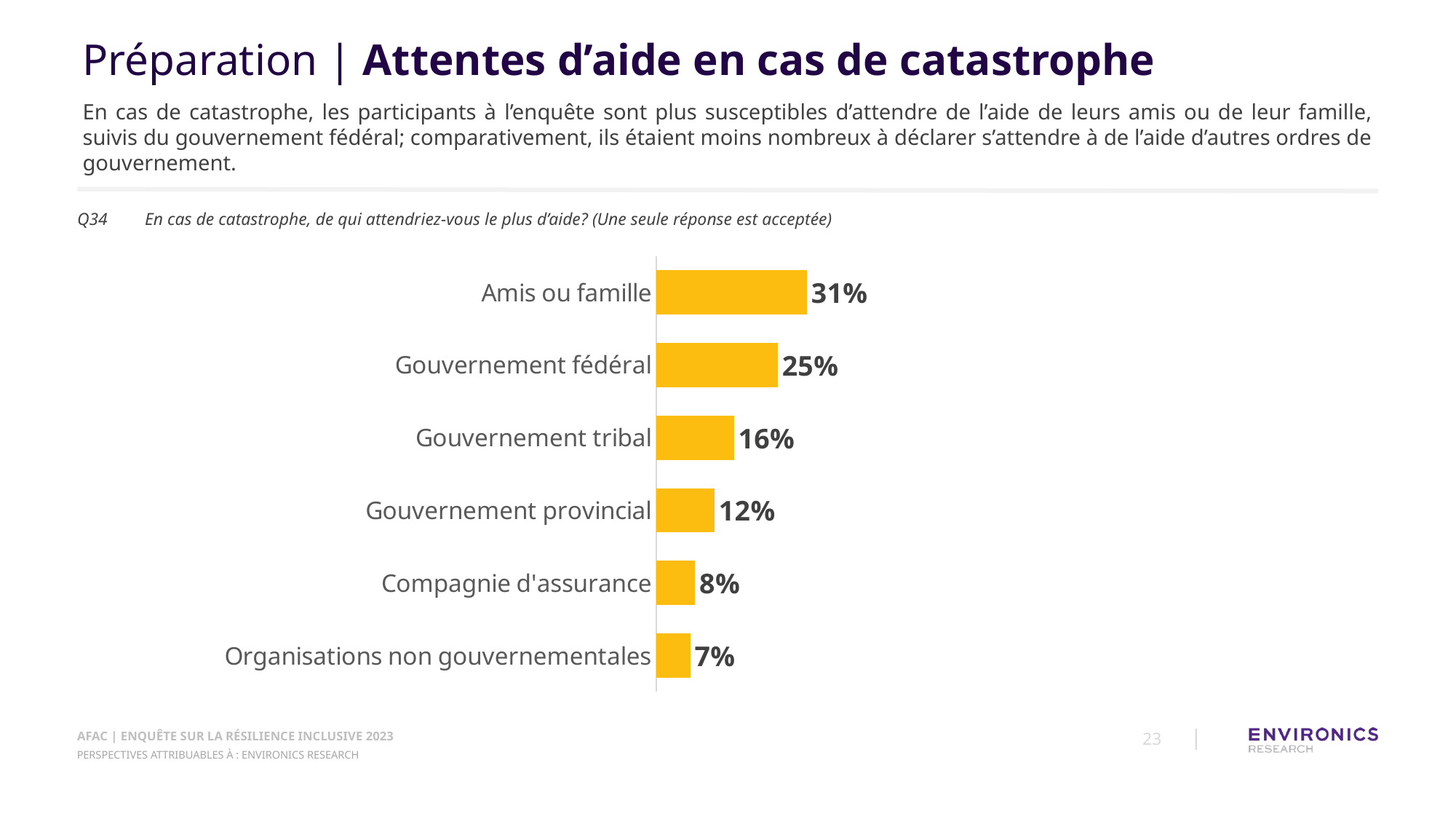
What is the value shown for Compagnie d'assurance? 8% What is the difference between the values for Amis ou famille and Gouvernement fédéral? 6% What is the value shown for Gouvernement tribal? 16% What colour are the bars in the chart? Yellow What is the difference between the values for Gouvernement tribal and Gouvernement provincial? 4% What percentage of respondents expect help from Amis ou famille? 31% Which category has the lowest value? Organisations non gouvernementales Which category has the highest value? Amis ou famille How many categories are shown in the chart? 6 Which is larger, the value for Gouvernement provincial or the value for Compagnie d'assurance? Gouvernement provincial What is the value shown for Gouvernement fédéral? 25% What kind of chart is shown on the slide? Bar chart